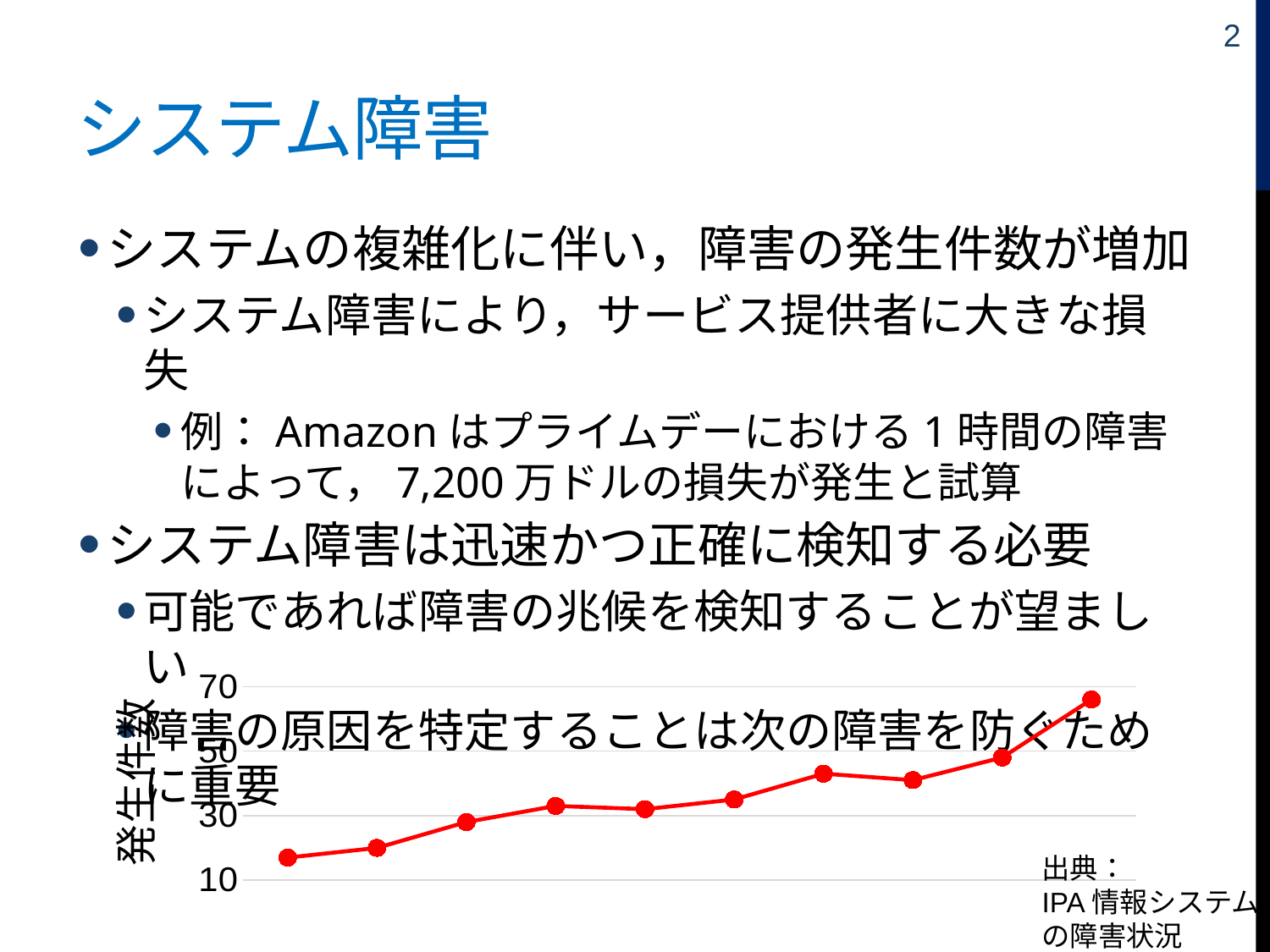
What colour is the line in the chart? red Is the value of the last (rightmost) point on the line chart greater or less than 70? less Do the values on the line chart generally rise or fall from left to right? rise How many data points are plotted on the line chart? 10 Which is larger on the line chart, the value of the first point or the value of the last point? the last point Which point on the line chart has the highest value, the first or the last? the last Which point on the line chart has the lowest value, the first or the last? the first What is the label on the vertical axis of the line chart? 発生件数 Is the value of the last (rightmost) point on the line chart greater or less than 50? greater Is the value of the first (leftmost) point on the line chart greater or less than 30? less What kind of chart is shown at the bottom of the slide? line chart